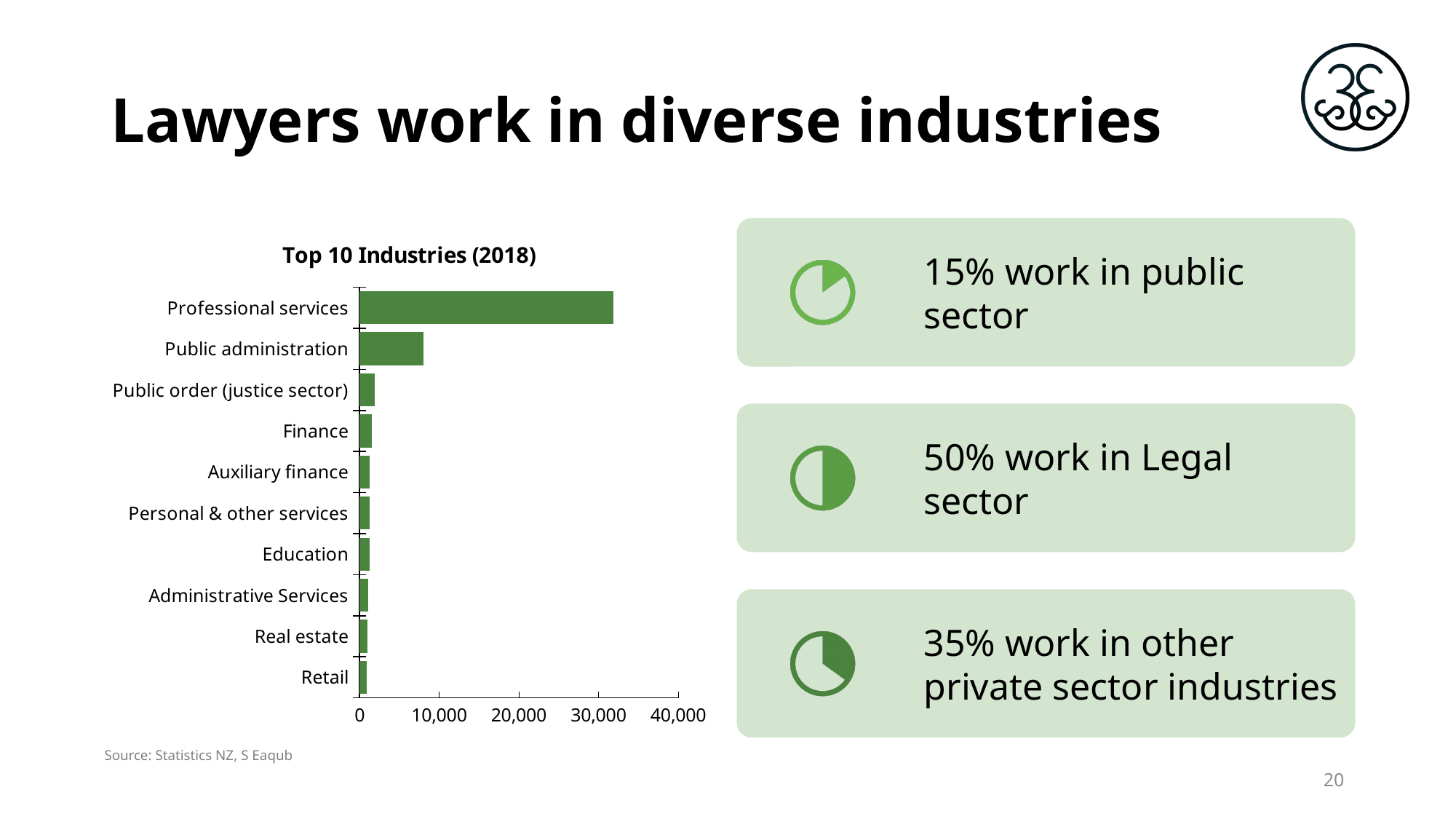
How many industries are plotted in the chart? 10 Which industry is listed second from the top in the chart? Public administration Is the value for Professional services greater or less than 30,000? greater Which is larger, the value for Public administration or the value for Finance? Public administration Which industry has the highest value in the chart? Professional services What is the title of the chart? Top 10 Industries (2018) Is the value for Public order (justice sector) greater or less than 10,000? less What is the highest tick value shown on the horizontal axis? 40,000 Which is larger, the value for Professional services or the value for Public administration? Professional services Is the value for Public administration greater or less than 10,000? less Do the bars get longer or shorter going from the top of the chart to the bottom? shorter What kind of chart is shown on the slide? bar chart